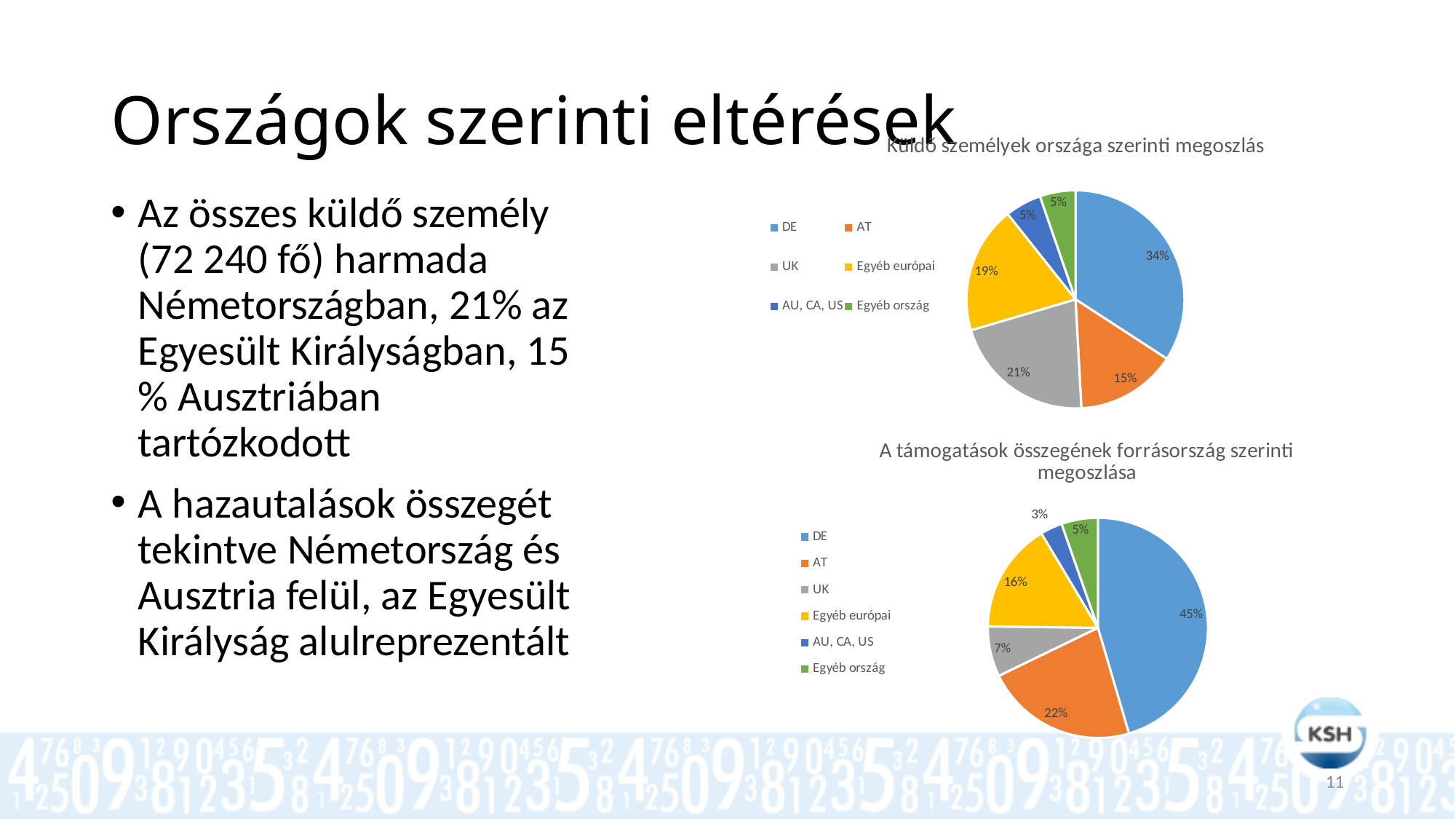
In the bottom pie chart (A támogatások összegének forrásország szerinti megoszlása), which category has the smallest share? AU, CA, US In the top pie chart (Küldő személyek országa szerinti megoszlás), which category has the largest share? DE In the top pie chart (Küldő személyek országa szerinti megoszlás), what share does DE have? 34% In the top pie chart (Küldő személyek országa szerinti megoszlás), what is the difference between the shares of UK and AT? 6% In the top pie chart (Küldő személyek országa szerinti megoszlás), how many slices does the pie have? 6 In the bottom pie chart (A támogatások összegének forrásország szerinti megoszlása), what share does DE have? 45% In the bottom pie chart (A támogatások összegének forrásország szerinti megoszlása), what is the difference between the shares of DE and AT? 23% In the top pie chart (Küldő személyek országa szerinti megoszlás), what share does UK have? 21% In the bottom pie chart (A támogatások összegének forrásország szerinti megoszlása), what share does AU, CA, US have? 3% What type of chart is used for both charts on the slide? Pie chart How many entries does the legend of the bottom pie chart (A támogatások összegének forrásország szerinti megoszlása) list? 6 In the bottom pie chart (A támogatások összegének forrásország szerinti megoszlása), which is larger, the share of AT or the share of Egyéb európai? AT